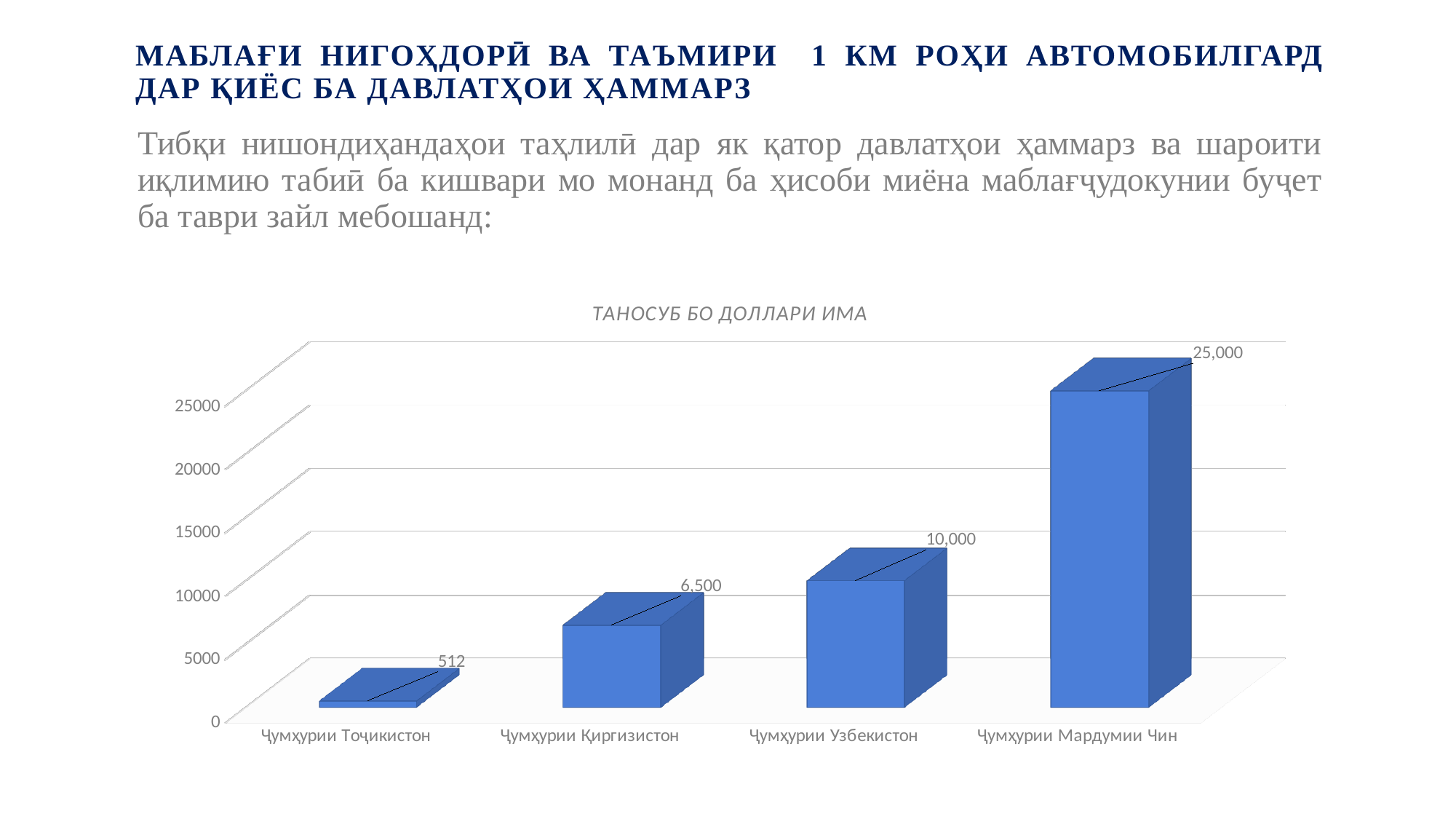
Which category has the lowest value? Ҷумҳурии Тоҷикистон What is the difference between the values for Ҷумҳурии Мардумии Чин and Ҷумҳурии Узбекистон? 15,000 How many categories are shown in the chart? 4 What is the value for Ҷумҳурии Узбекистон? 10,000 What is the value for Ҷумҳурии Тоҷикистон? 512 What kind of chart is shown on the slide? Bar chart Which is larger, the value for Ҷумҳурии Узбекистон or Ҷумҳурии Қиргизистон? Ҷумҳурии Узбекистон What is the title of the chart? ТАНОСУБ БО ДОЛЛАРИ ИМА Which category has the highest value? Ҷумҳурии Мардумии Чин What is the value for Ҷумҳурии Мардумии Чин? 25,000 What is the value for Ҷумҳурии Қиргизистон? 6,500 What is the difference between the values for Ҷумҳурии Қиргизистон and Ҷумҳурии Тоҷикистон? 5,988